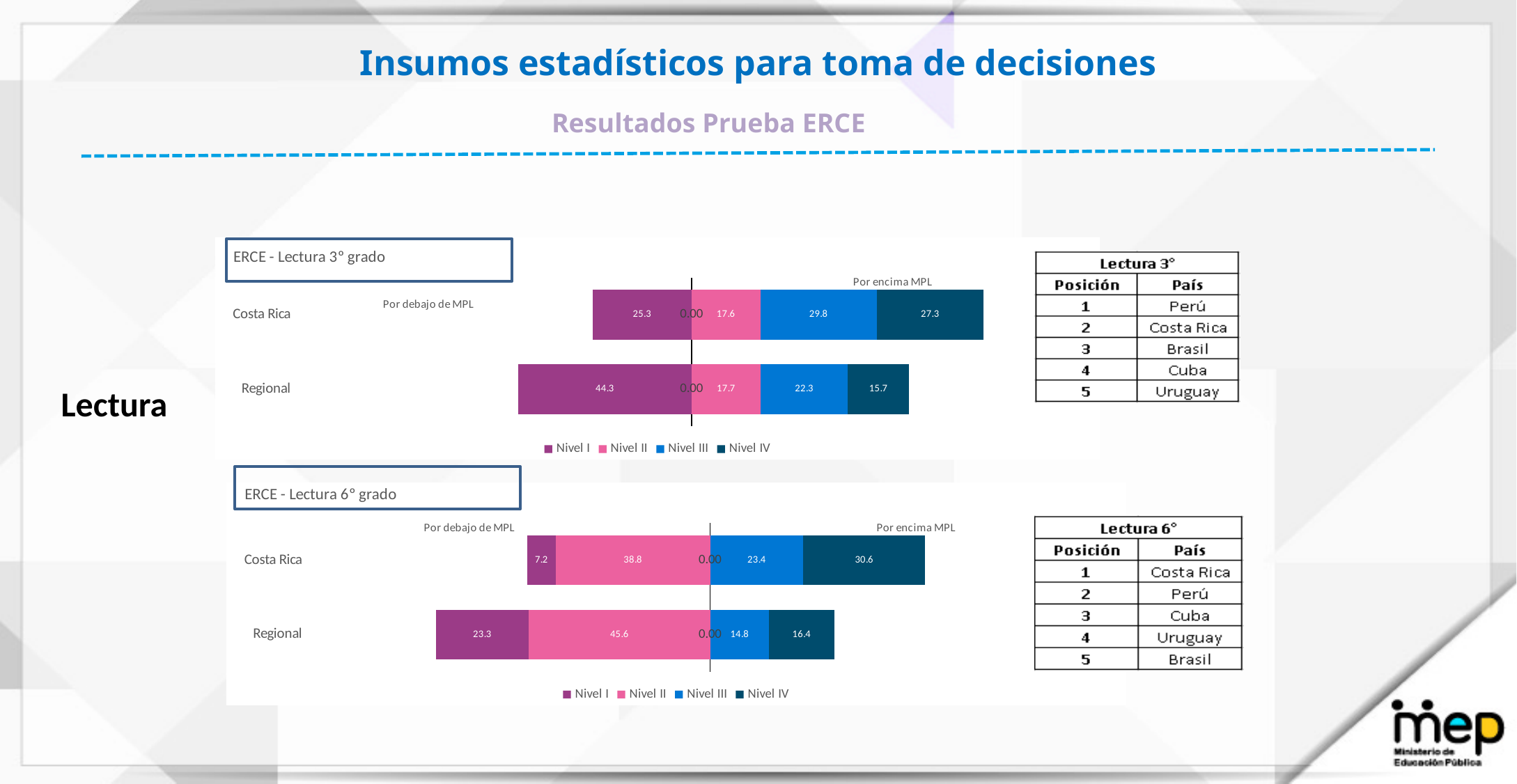
What kind of chart is the ERCE - Lectura 3° grado chart? Stacked bar chart In the ERCE - Lectura 3° grado chart, what is the difference between the Nivel I values for Regional and Costa Rica? 19.0 In the ERCE - Lectura 6° grado chart, what is the Nivel II value for Costa Rica? 38.8 How many series does the legend of the ERCE - Lectura 6° grado chart list? 4 In the ERCE - Lectura 3° grado chart, what is the Nivel I value for Costa Rica? 25.3 In the ERCE - Lectura 3° grado chart, what is the total of the four Nivel values for Costa Rica? 100.0 In the ERCE - Lectura 6° grado chart, which is larger: the Nivel IV value for Costa Rica or for Regional? Costa Rica In the ERCE - Lectura 6° grado chart, which level has the lowest value for Costa Rica? Nivel I How many categories are shown in the ERCE - Lectura 3° grado chart? 2 In the ERCE - Lectura 3° grado chart, which level has the highest value for Regional? Nivel I In the ERCE - Lectura 3° grado chart, what is the Nivel IV value for Regional? 15.7 In the ERCE - Lectura 6° grado chart, what is the Nivel III value for Regional? 14.8